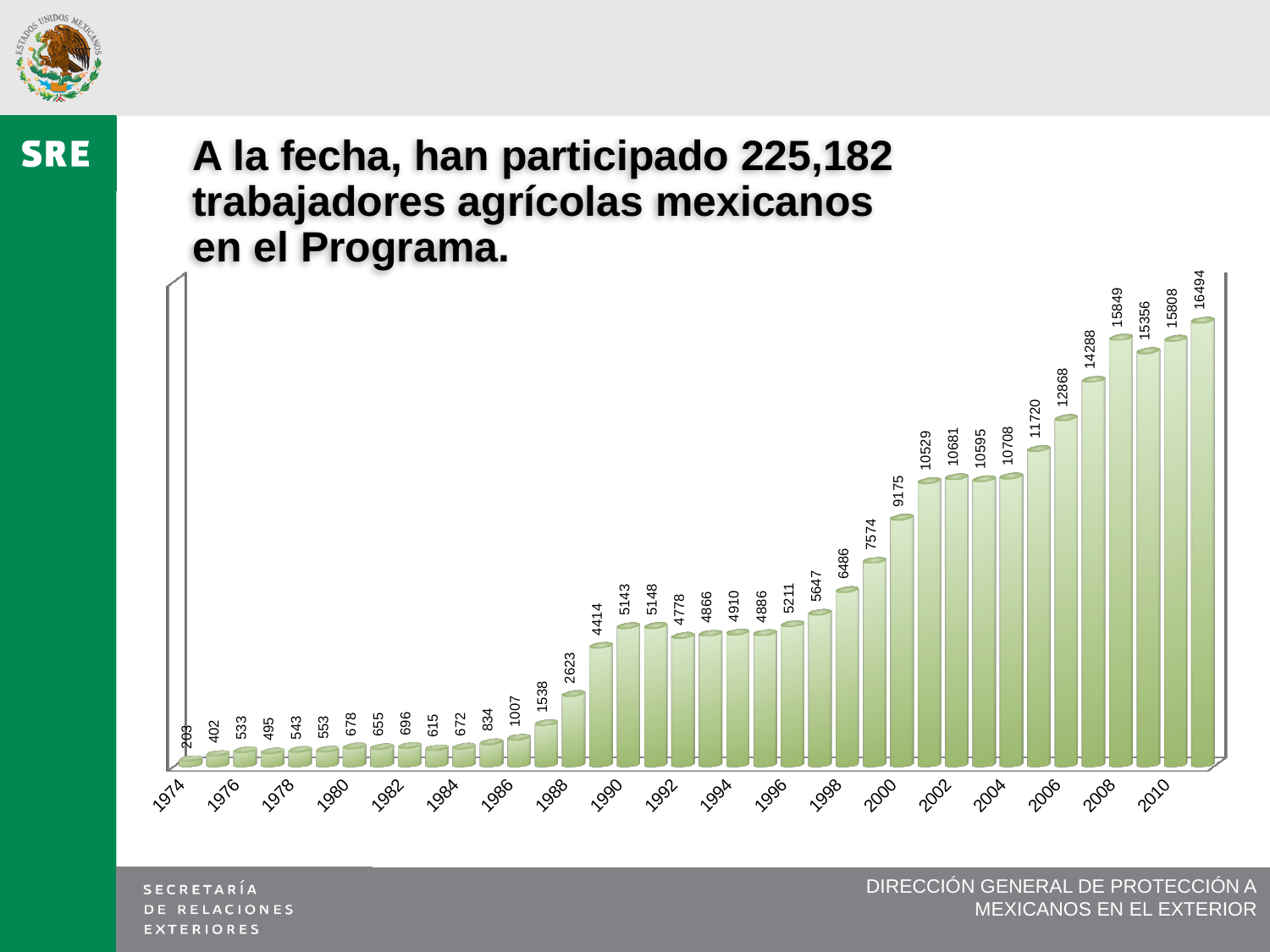
Do the values generally rise or fall from 1974 to 2010? rise What total number of participants is stated in the slide title? 225,182 What is the highest value shown in the chart? 16494 What is the difference between the values for 2000 and 1990? 4032 What is the value for 1980? 678 Which year has the lowest value? 1974 What kind of chart is shown on the slide? bar chart What is the value for 2010? 15808 What is the value for 1990? 5143 What is the lowest value shown in the chart? 203 Which is larger, the value for 2006 or the value for 1998? 2006 What is the value for 2000? 9175